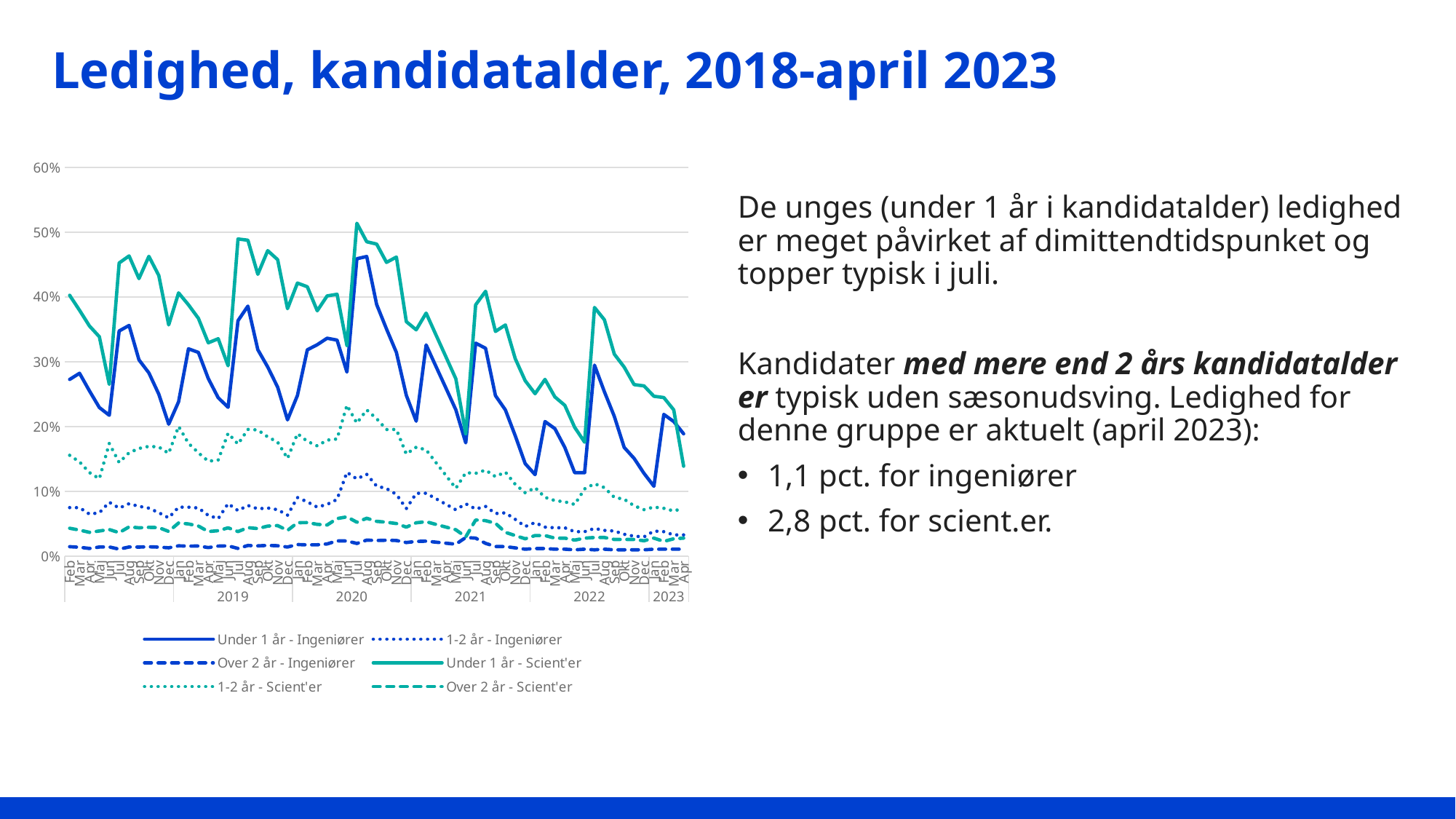
Is the value for 'Over 2 år - Ingeniører' in April 2023 greater or less than 10%? less Is the peak value of 'Under 1 år - Ingeniører' in 2020 greater or less than 40%? greater Which series stays lowest across the whole chart? Over 2 år - Ingeniører What kind of chart is shown on the slide? line chart What is the title of the slide containing the chart? Ledighed, kandidatalder, 2018-april 2023 Is the peak value of 'Under 1 år - Scient'er' in 2020 greater or less than 40%? greater Which series reaches the highest value anywhere on the chart? Under 1 år - Scient'er How many series does the chart legend list? 6 Do the yearly peaks of 'Under 1 år - Scient'er' rise or fall from 2020 to 2023? fall In July 2020, which series is higher: 'Under 1 år - Scient'er' or 'Under 1 år - Ingeniører'? Under 1 år - Scient'er What is the highest value shown on the vertical axis? 60%